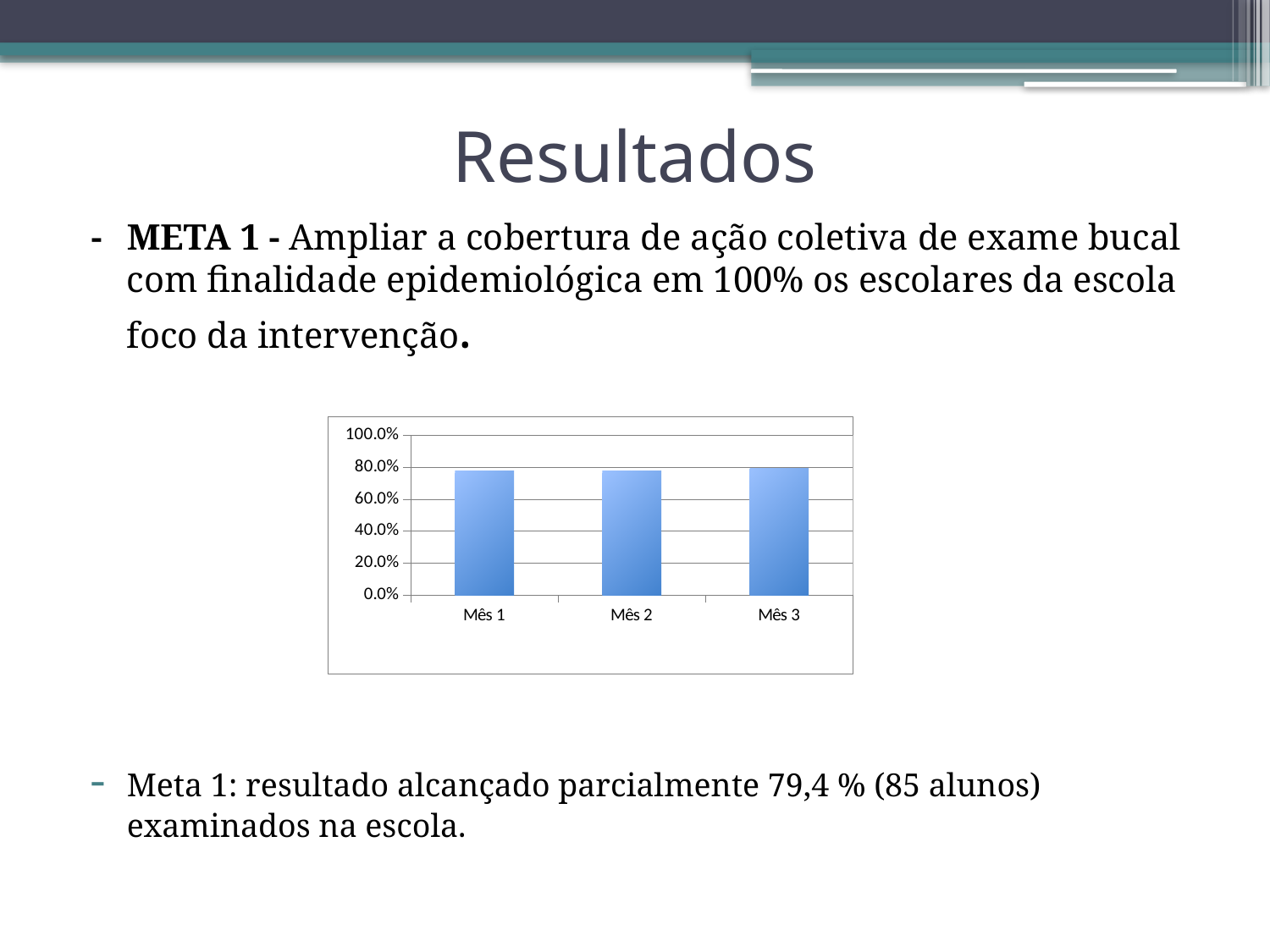
What kind of chart is shown on the slide? bar chart What is the label of the first category on the x axis of the chart? Mês 1 What is the highest tick label shown on the y axis of the chart? 100.0% Is the value for Mês 3 greater or less than 60.0%? greater Is the value for Mês 1 greater or less than 60.0%? greater Is the value for Mês 2 greater or less than 100.0%? less How many categories are shown on the x axis of the chart? 3